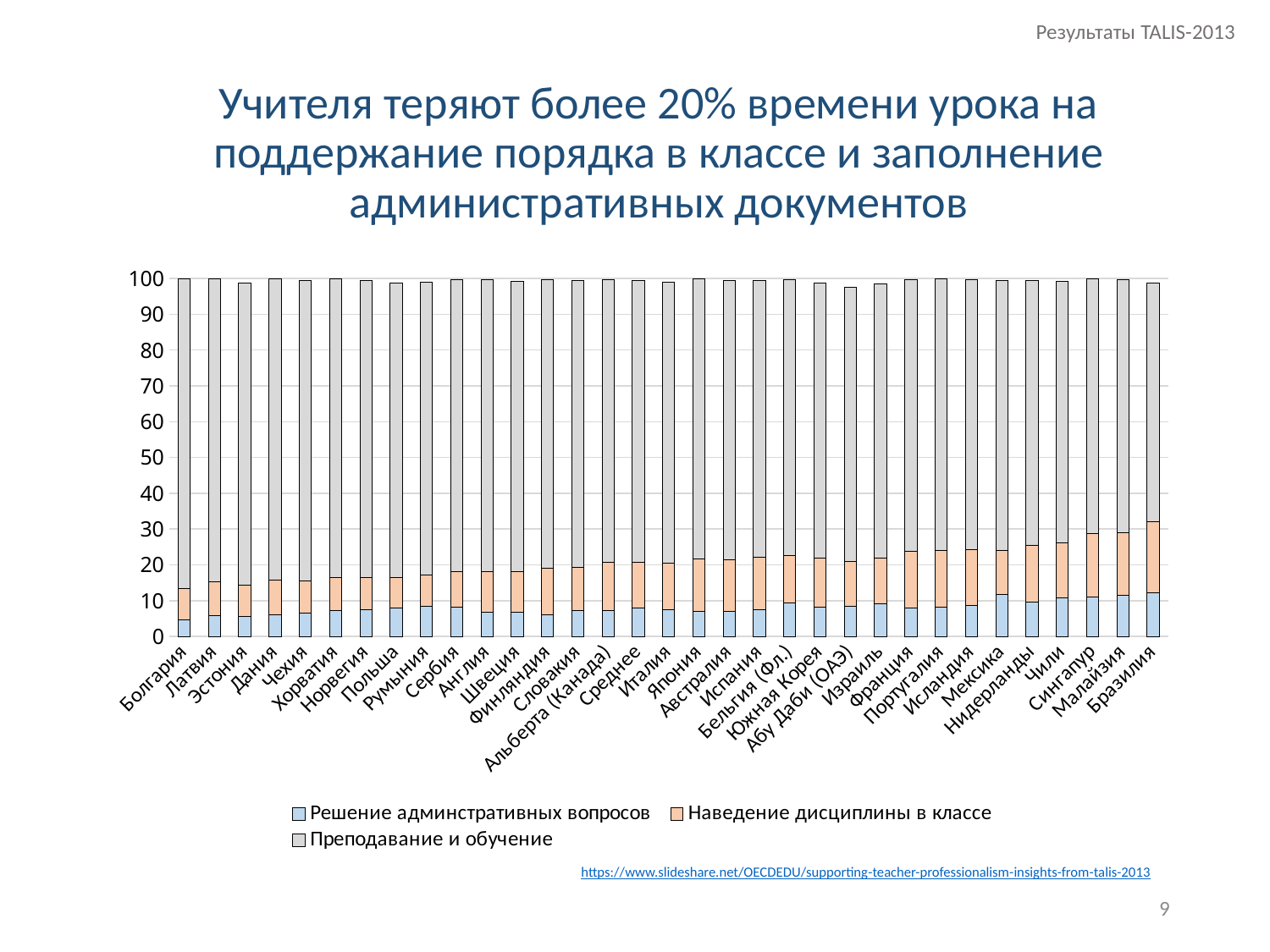
Which category is listed first on the x axis? Болгария What kind of chart is shown on the slide? Stacked bar chart Which series is shown in grey and forms the top segment of each bar? Преподавание и обучение Is the value of 'Решение админстративных вопросов' for Мексика greater or less than 10? greater Is the combined value of the two lower segments (administrative issues plus discipline) for Болгария greater or less than 20? less Is the combined value of the two lower segments (administrative issues plus discipline) for Бразилия greater or less than 30? greater How many countries/categories are plotted along the x axis? 33 How many series does the legend list? 3 Moving from left to right along the x axis, does the combined share of time lost to administrative issues and discipline rise or fall? rise Which category has the largest combined share of time spent on administrative issues and discipline? Бразилия Which is larger, the 'Решение админстративных вопросов' value for Бразилия or for Болгария? Бразилия